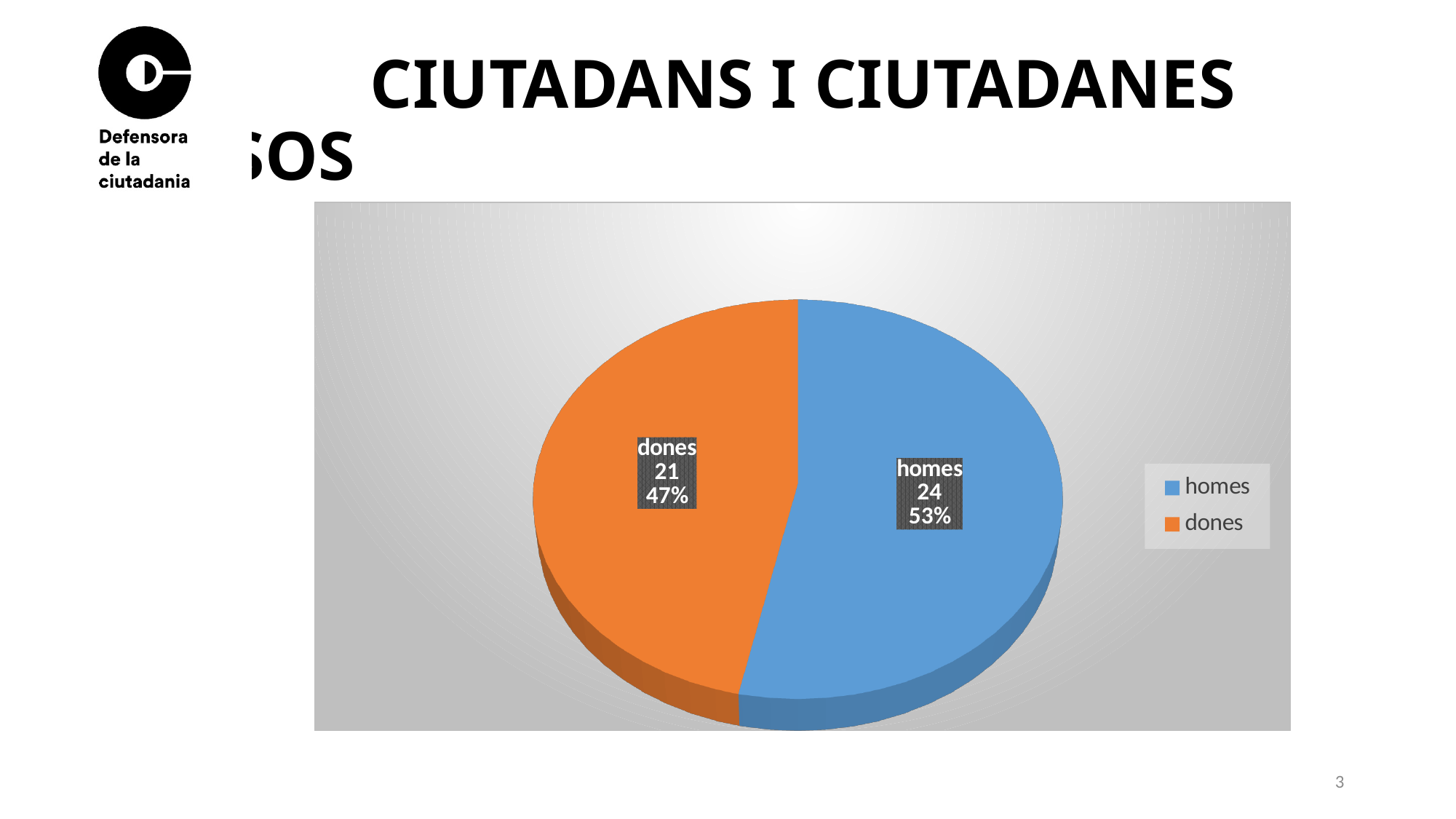
Which is larger, the value for homes or the value for dones? homes Which category has the largest slice? homes What is the difference between the values for homes and dones? 3 What colour is the slice for dones? orange How many slices does the pie chart have? 2 What percentage share of the pie does homes have? 53% What percentage share of the pie does dones have? 47% How many entries does the legend list? 2 Which category has the smallest slice? dones What is the value for homes? 24 What is the value for dones? 21 What kind of chart is shown on the slide? pie chart